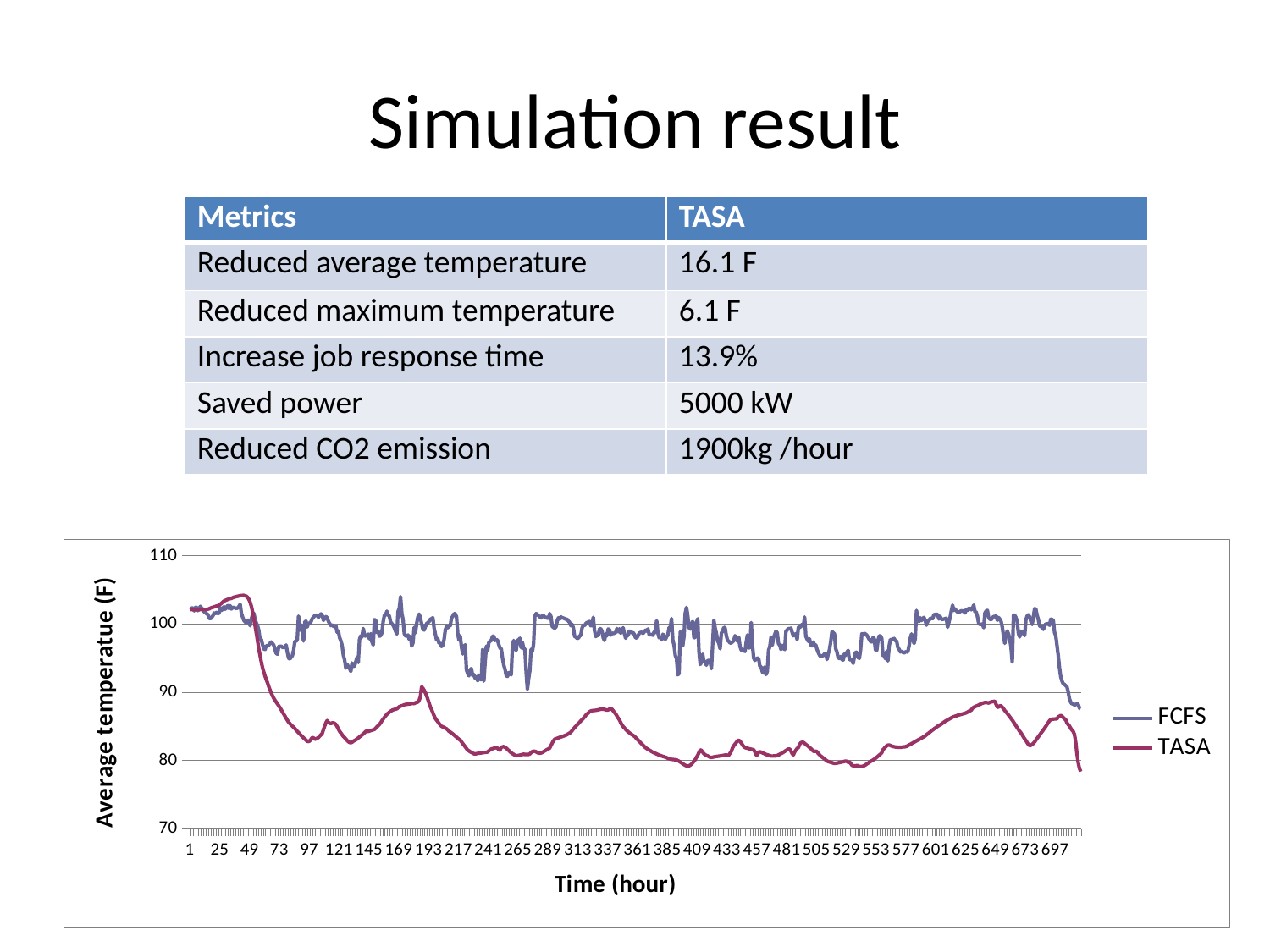
Which series, FCFS or TASA, has the higher average temperature for most of the time range? FCFS What are the two series named in the chart legend? FCFS and TASA Is the TASA value at hour 409 greater or less than 90? less Which series, FCFS or TASA, has the lower value at hour 529? TASA How many series does the chart legend list? 2 Is the FCFS value at hour 313 greater or less than 90? greater Does the TASA series rise or fall between hour 49 and hour 97? fall Is the FCFS value at hour 409 greater or less than 90? greater What is the title of the chart's x axis? Time (hour) What kind of chart is shown on the slide? line chart Does the TASA series rise or fall between hour 553 and hour 649? rise